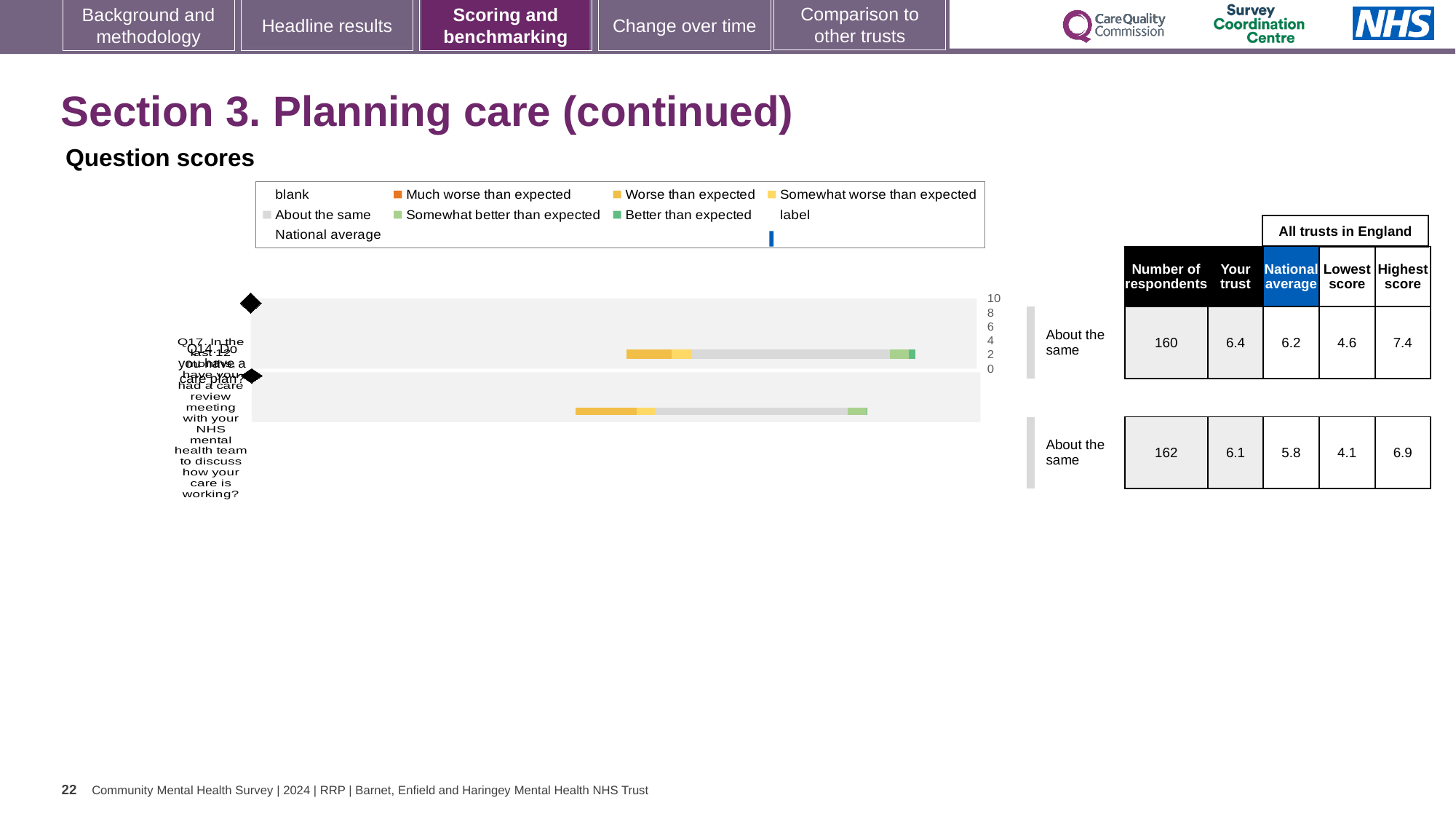
What is the highest value shown on the chart's numeric axis? 10 In the table, what is the difference between the highest score and the lowest score for Q17? 2.8 In the table next to the chart, what is the 'Your trust' score for Q14 (Do you have a care plan?)? 6.4 Which legend entry is shown with a blue marker? National average How many survey questions are plotted as bars in the chart? 2 In the table next to the chart, what is the lowest score across all trusts in England for Q14? 4.6 In the table next to the chart, what is the number of respondents for Q14 (Do you have a care plan?)? 160 For Q14, is the 'Your trust' score or the national average higher in the table? Your trust In the table next to the chart, what is the highest score across all trusts in England for Q17? 6.9 In the table next to the chart, what is the national average for Q17 (care review meeting in the last 12 months)? 5.8 Which question has more respondents in the table, Q14 or Q17? Q17 What kind of chart is shown on the slide? bar chart